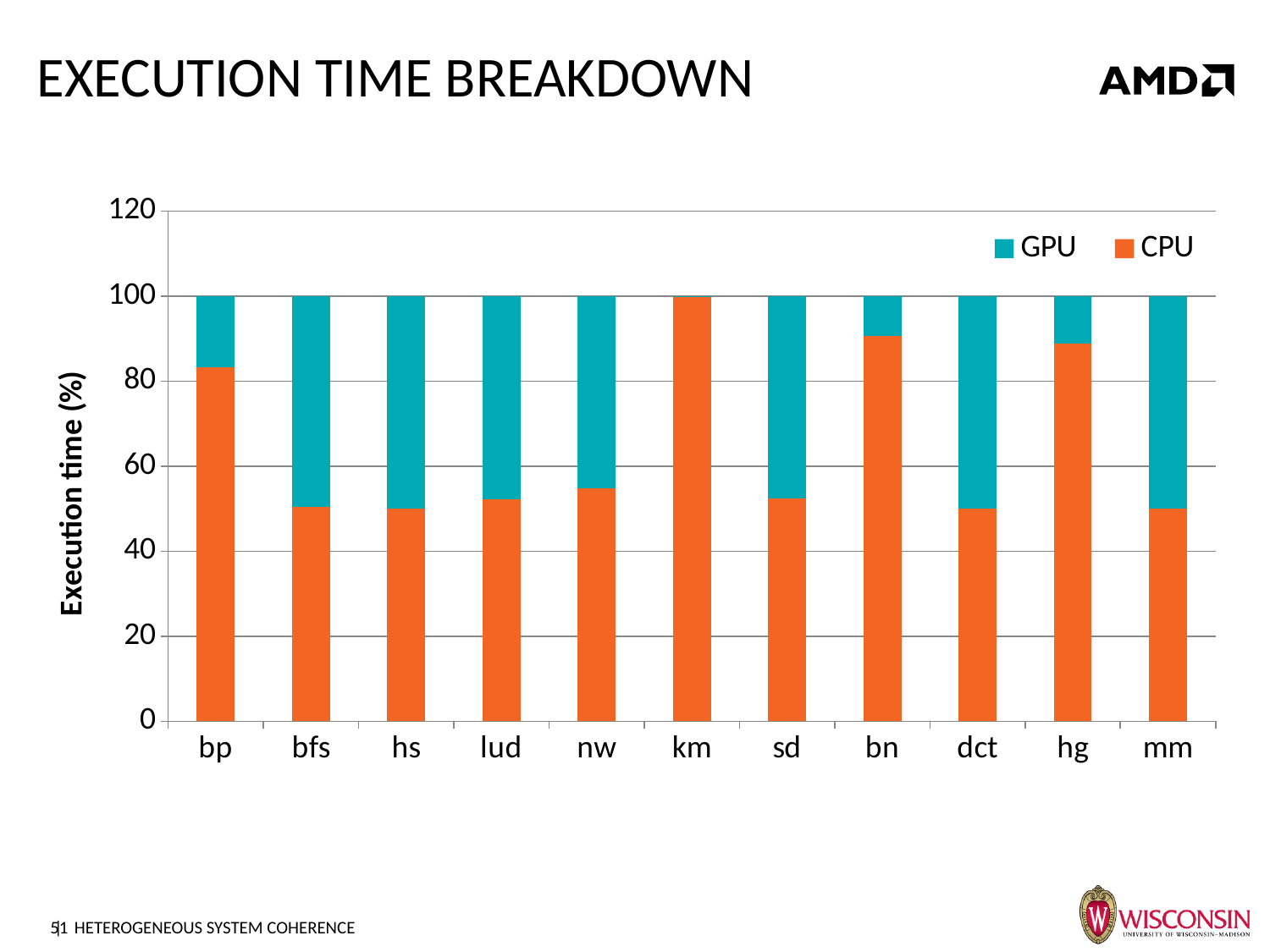
Which benchmark has the highest CPU share of execution time? km Is the CPU value for nw greater or less than 60? less How many benchmark categories are shown on the x axis? 11 Is the CPU value for hg greater or less than 100? less Is the CPU value for bn greater or less than 80? greater What is the total height of the stacked bar for lud? 100 What kind of chart is shown on the slide? stacked bar chart What is the label of the y axis? Execution time (%) Which has a larger CPU share of execution time, bp or bfs? bp How many series does the legend list? 2 Which benchmark has the lowest GPU share of execution time? km